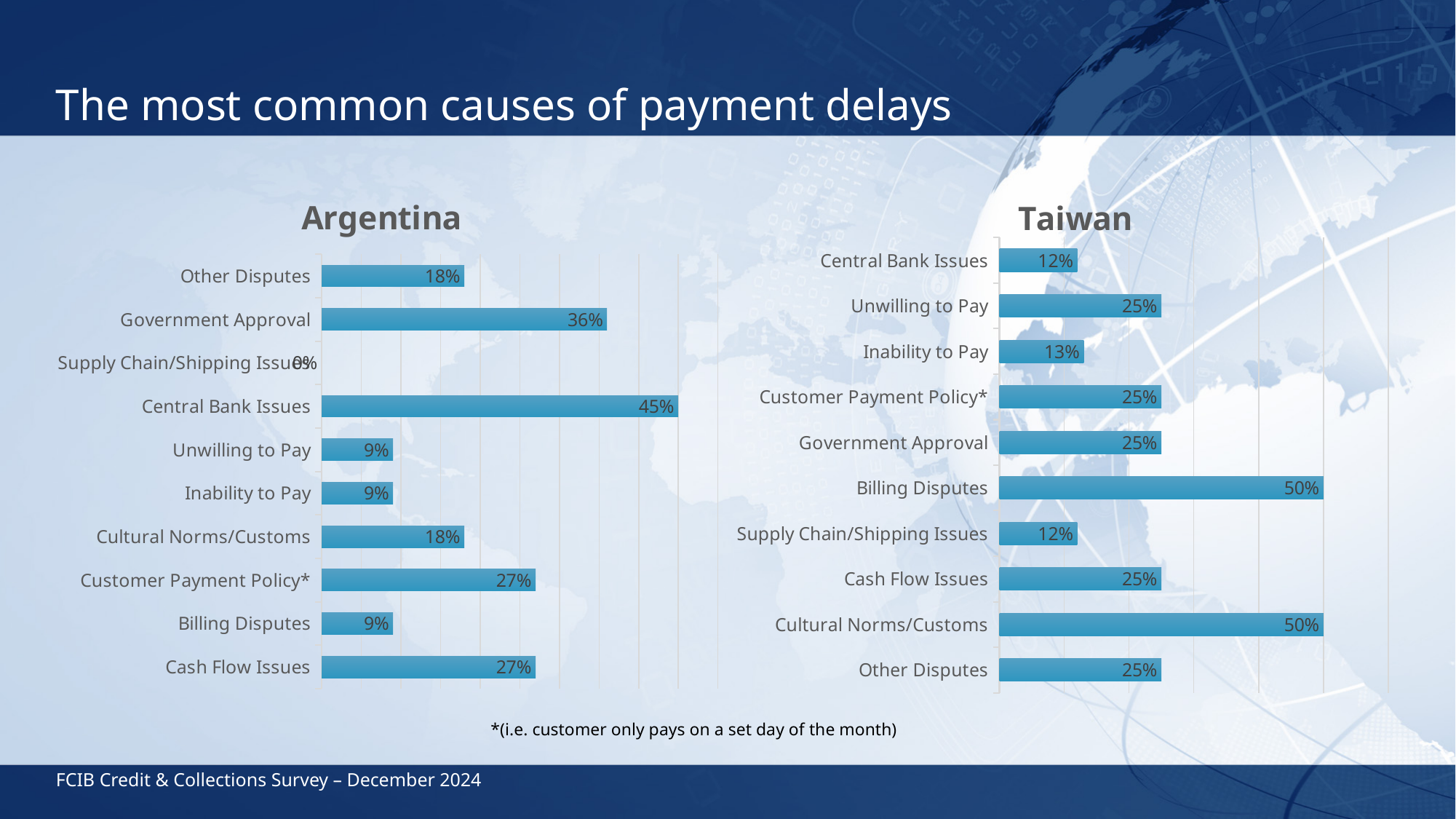
In the Argentina chart, which category has the lowest value? Supply Chain/Shipping Issues In the Taiwan chart, which category has the lowest value? Central Bank Issues and Supply Chain/Shipping Issues (both 12%) How many categories does the Taiwan chart show? 10 In the Argentina chart, what is the difference between Government Approval and Other Disputes? 18% Which is larger: Billing Disputes in the Argentina chart or Billing Disputes in the Taiwan chart? Taiwan In the Taiwan chart, what is the difference between Billing Disputes and Central Bank Issues? 38% In the Argentina chart, which category has the highest value? Central Bank Issues In the Argentina chart, what is the value for Central Bank Issues? 45% What kind of chart is the Argentina chart? Bar chart What is the title of the slide? The most common causes of payment delays In the Argentina chart, what is the value for Government Approval? 36% In the Taiwan chart, what is the value for Inability to Pay? 13%